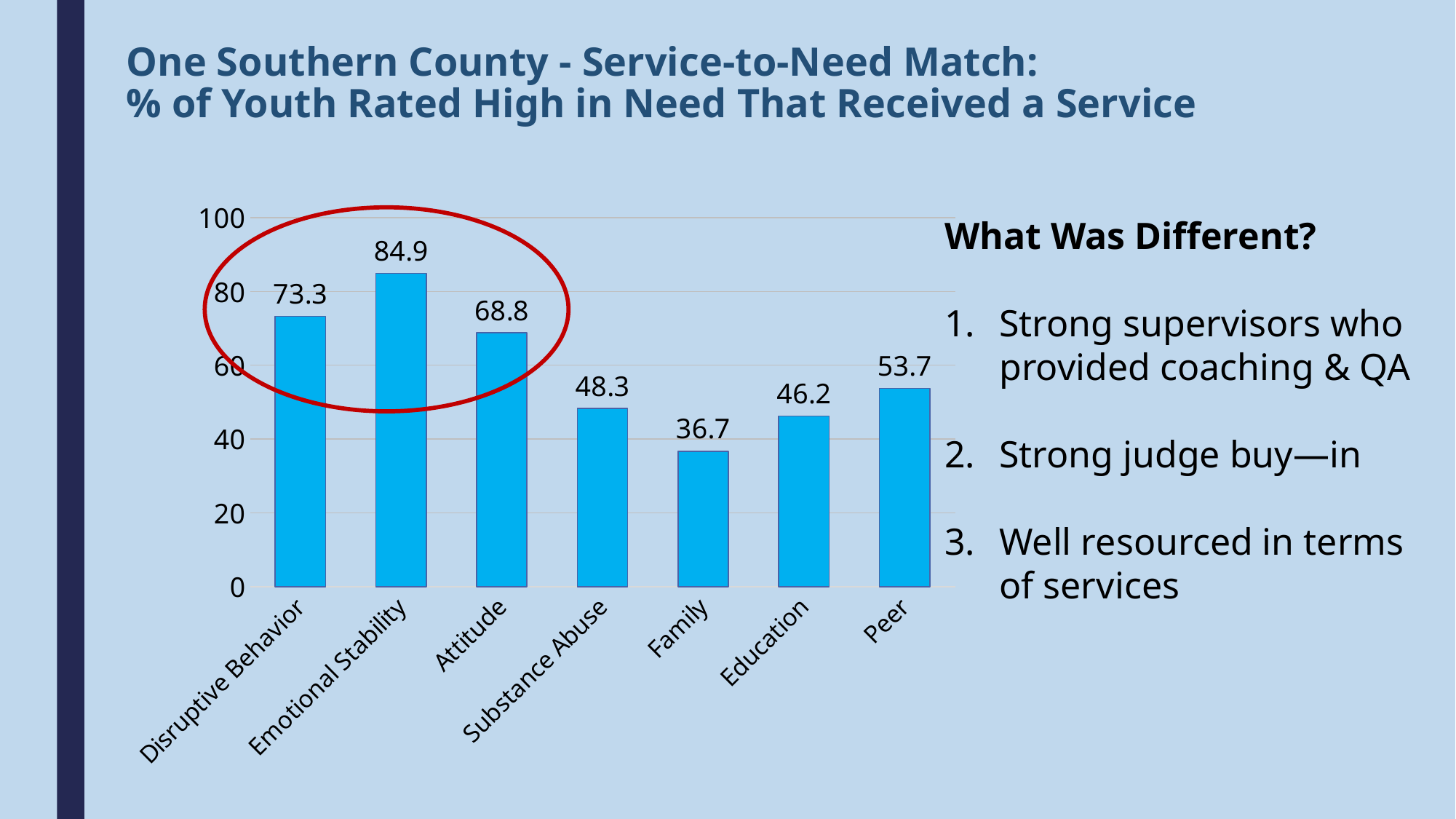
What is the difference between the highest and lowest values in the chart? 48.2 How many categories are shown on the x axis? 7 Which category has the highest value? Emotional Stability Which three categories are circled in red on the chart? Disruptive Behavior, Emotional Stability, Attitude What is the value for Peer? 53.7 Is the value for Peer greater or less than 60? less Which is larger, the value for Substance Abuse or the value for Education? Substance Abuse What is the difference between the values for Disruptive Behavior and Attitude? 4.5 What kind of chart is shown on the slide? bar chart What is the value for Family? 36.7 What is the value for Emotional Stability? 84.9 Which category has the lowest value? Family